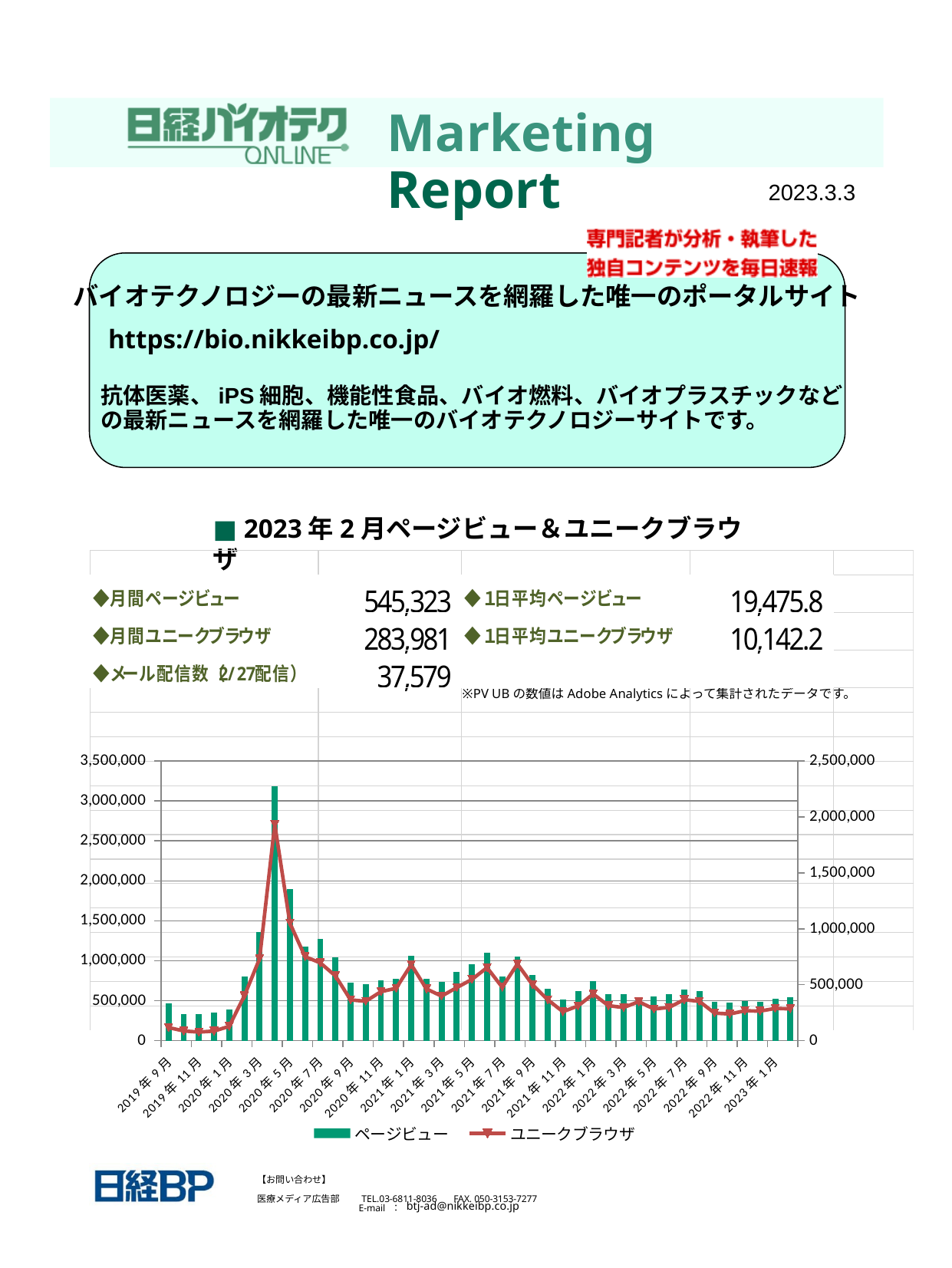
Is the ページビュー bar for 2020年7月 greater or less than 1,000,000? greater Is the ページビュー bar for 2020年5月 greater or less than 1,500,000? greater What kind of chart is shown on the slide? A combined bar and line chart Do the ページビュー bars rise or fall from 2020年5月 to 2020年9月? fall What is the highest value shown on the left vertical axis of the chart? 3,500,000 Which series is drawn as bars in the chart? ページビュー Which has the larger ページビュー bar, 2020年1月 or 2020年3月? 2020年3月 How many series does the chart legend list? 2 What is the 月間ユニークブラウザ value printed above the chart? 283,981 Which has the larger ページビュー bar, 2020年5月 or 2020年7月? 2020年5月 What is the 月間ページビュー value printed above the chart? 545,323